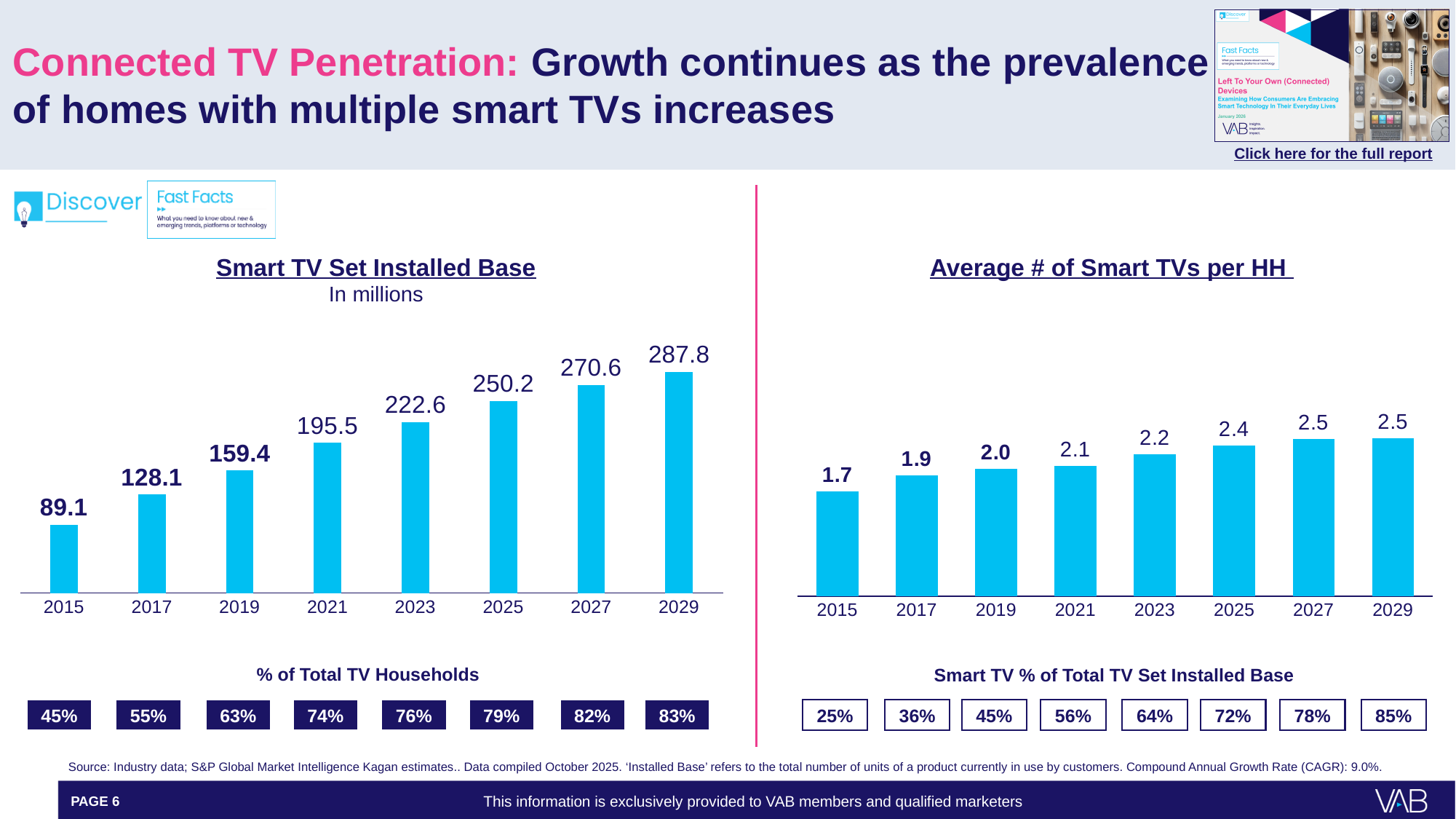
In the 'Smart TV Set Installed Base' chart, which is larger, the value for 2023 or the value for 2019? 2023 In the 'Smart TV Set Installed Base' chart, what is the value for 2021? 195.5 What kind of chart is the 'Smart TV Set Installed Base' chart? bar chart In the 'Average # of Smart TVs per HH' chart, which year has the lowest value? 2015 In the 'Smart TV Set Installed Base' chart, which year has the lowest value? 2015 In the 'Smart TV Set Installed Base' chart, what is the difference between the 2029 and 2015 values? 198.7 In the 'Smart TV Set Installed Base' chart, do the values rise or fall from 2015 to 2029? rise In the 'Average # of Smart TVs per HH' chart, what is the difference between the 2025 and 2017 values? 0.5 In the 'Smart TV Set Installed Base' chart, how many years are plotted? 8 In the 'Average # of Smart TVs per HH' chart, what is the value for 2023? 2.2 In the 'Smart TV Set Installed Base' chart, what unit are the values given in, according to the subtitle? In millions In the 'Average # of Smart TVs per HH' chart, which is larger, the value for 2019 or the value for 2027? 2027